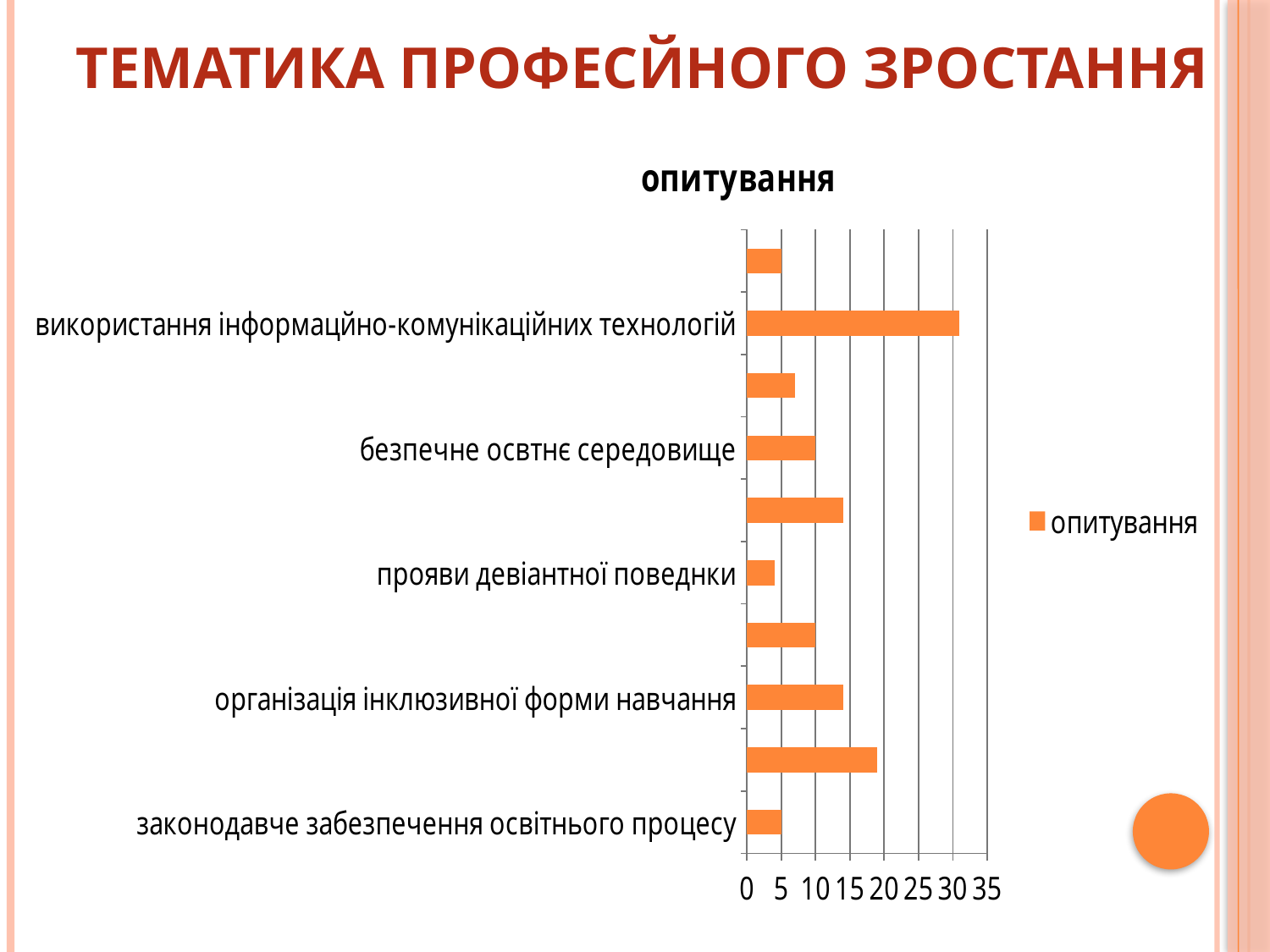
What kind of chart is shown on the slide? bar chart Which category has the highest value? використання інформаційно-комунікаційних технологій Is the value for використання інформаційно-комунікаційних технологій greater or less than 25? greater Is the value for безпечне освтнє середовище greater or less than 15? less Is the value for законодавче забезпечення освітнього процесу greater or less than 10? less Which is larger: the value for використання інформаційно-комунікаційних технологій or the value for безпечне освтнє середовище? використання інформаційно-комунікаційних технологій How many series does the legend list? 1 Which is larger: the value for організація інклюзивної форми навчання or the value for прояви девіантної поведнки? організація інклюзивної форми навчання How many bars are plotted in the chart? 10 What is the title of the chart? опитування